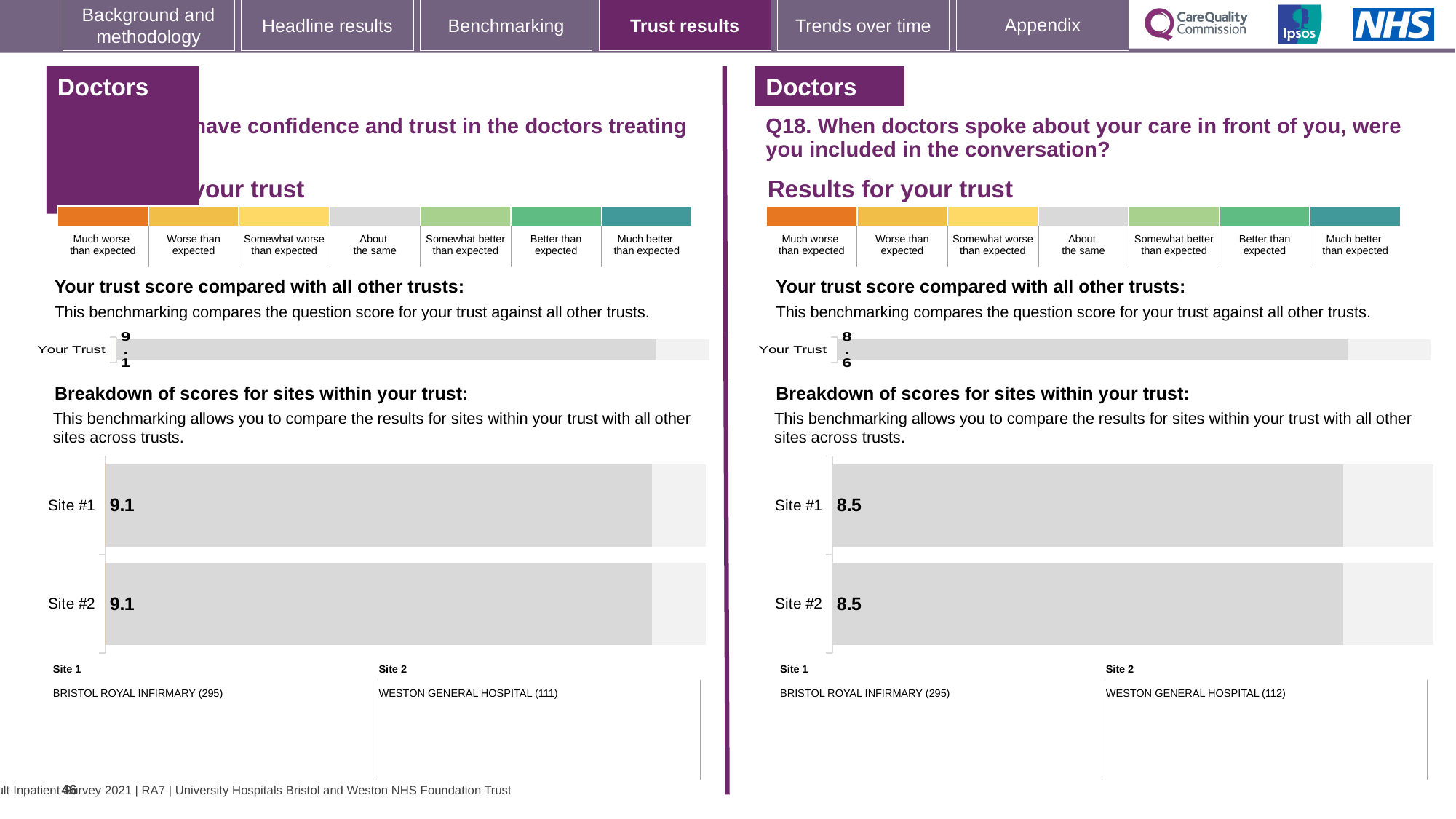
What is the difference between the Your Trust score on the left-hand chart and the Your Trust score on the right-hand chart (Q18)? 0.5 What kind of chart is the right-hand 'Breakdown of scores for sites within your trust' chart (Q18)? Bar chart On the left-hand 'Breakdown of scores for sites within your trust' chart, what is the score for Site #1? 9.1 On the left-hand 'Breakdown of scores for sites within your trust' chart, what is the score for Site #2? 9.1 Which is larger: the Your Trust score on the left-hand chart or the Your Trust score on the right-hand chart (Q18)? The left-hand chart (9.1) On the right-hand chart 'Your trust score compared with all other trusts' (Q18), what is the score for Your Trust? 8.6 On the right-hand 'Breakdown of scores for sites within your trust' chart (Q18), what is the difference between the scores for Site #1 and Site #2? 0 How many sites are shown on the right-hand 'Breakdown of scores for sites within your trust' chart (Q18)? 2 On the left-hand chart 'Your trust score compared with all other trusts', what is the score for Your Trust? 9.1 How many sites are shown on the left-hand 'Breakdown of scores for sites within your trust' chart? 2 On the right-hand 'Breakdown of scores for sites within your trust' chart (Q18), what is the score for Site #2? 8.5 On the right-hand 'Breakdown of scores for sites within your trust' chart (Q18), what is the score for Site #1? 8.5